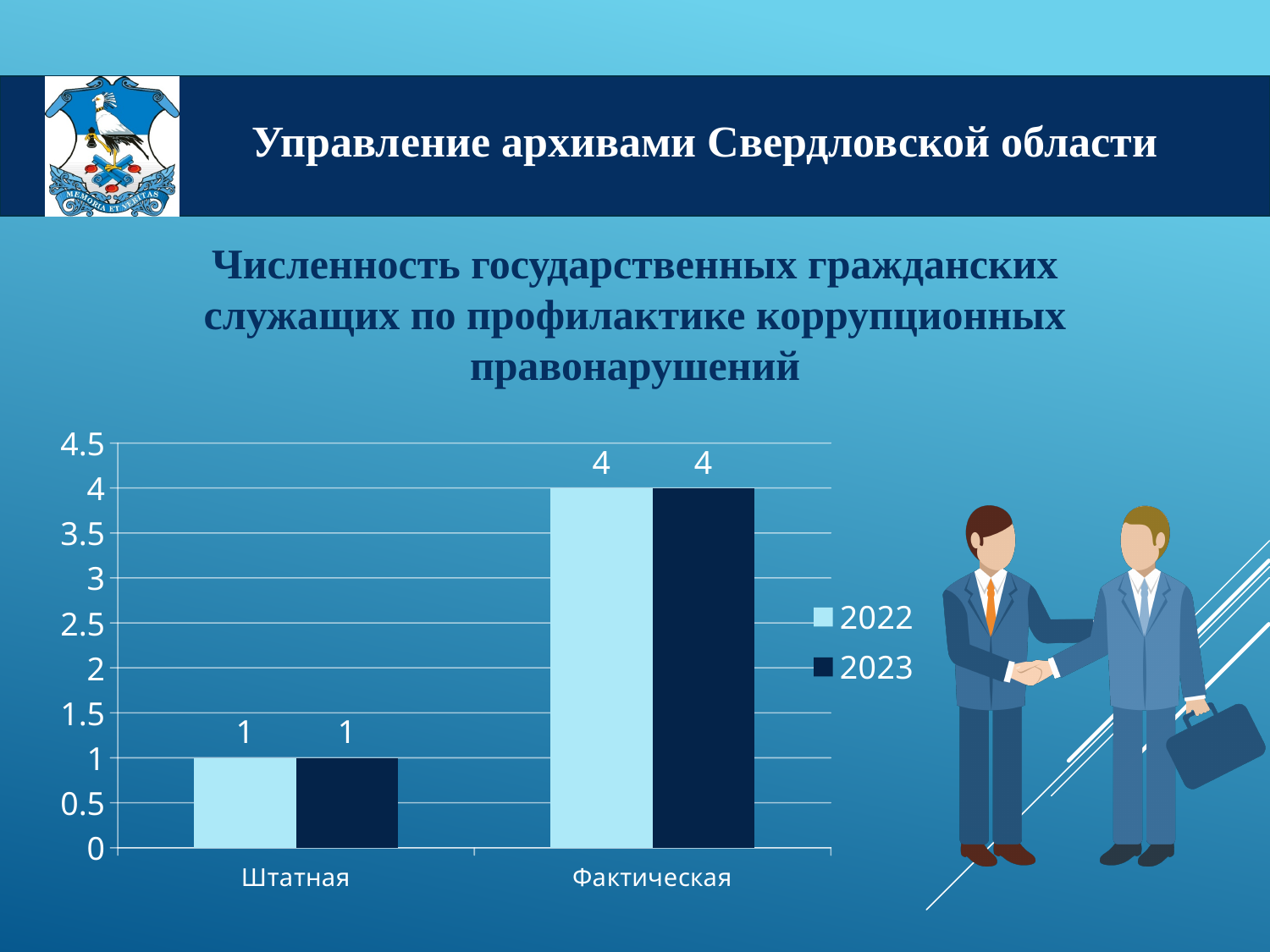
Which category has the highest value in 2023? Фактическая What is the difference between Фактическая and Штатная in 2022? 3 Which category has the lowest value in 2022? Штатная Which is larger in 2023: Штатная or Фактическая? Фактическая What is the value for Фактическая in 2023? 4 What kind of chart is shown on the slide? bar chart How many categories are shown on the x axis? 2 How many series does the legend list? 2 Which series is shown in dark navy in the legend? 2023 What is the value for Фактическая in 2022? 4 What is the value for Штатная in 2022? 1 What is the value for Штатная in 2023? 1